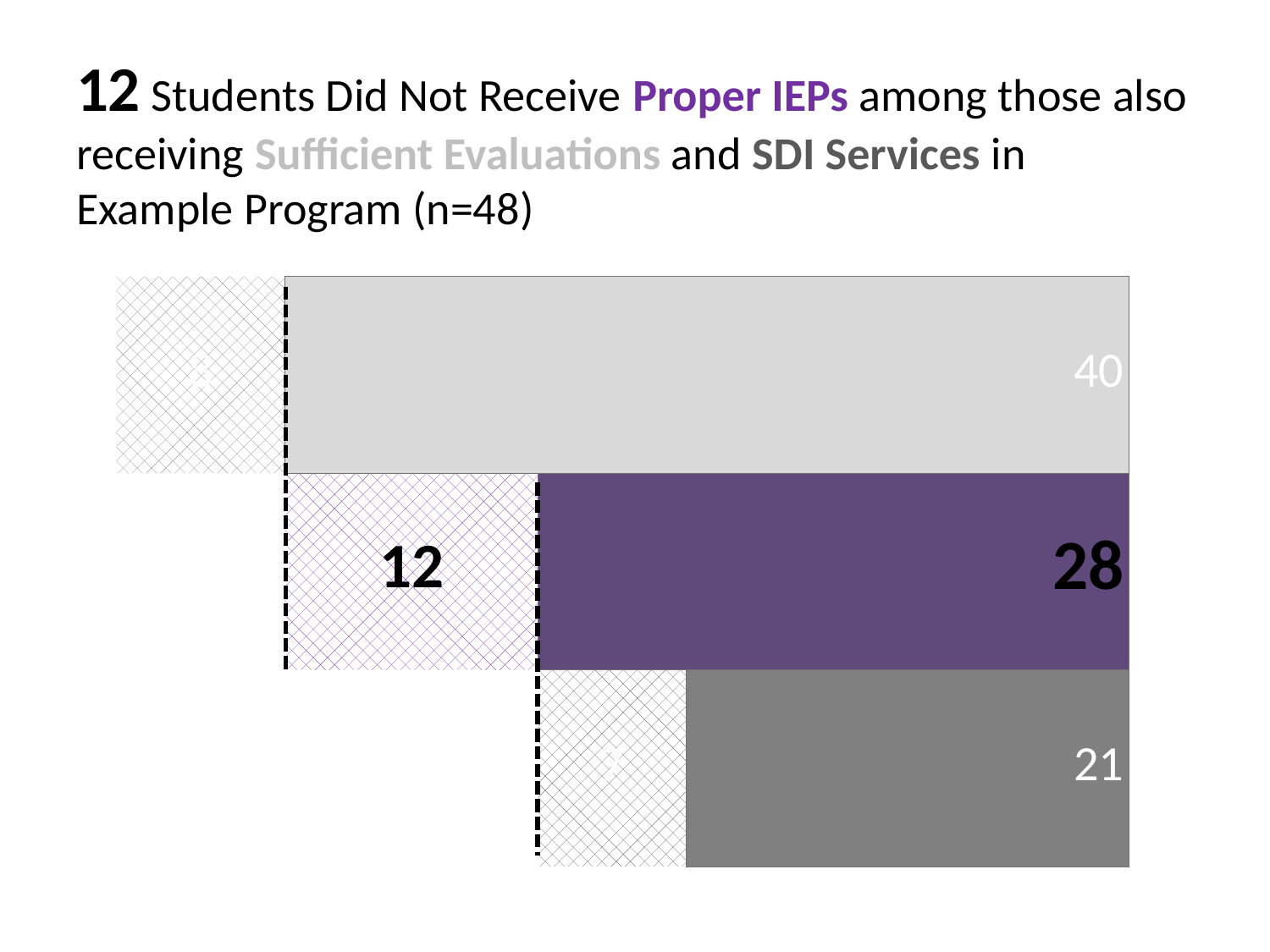
What value is printed on the top (light grey) bar of the chart? 40 Which bar shows the highest printed value: the top light grey bar, the middle purple bar, or the bottom dark grey bar? the top light grey bar What value is printed on the solid purple portion of the middle bar? 28 What is the difference between the value on the top light grey bar (40) and the solid purple value on the middle bar (28)? 12 What is the total of the hatched portion (12) and the solid portion (28) of the middle purple bar? 40 What value is printed on the hatched portion of the middle (purple) bar? 12 What value is printed on the bottom (dark grey) bar of the chart? 21 What type of chart is shown on the slide? bar chart What is the difference between the solid purple value (28) and the bottom dark grey bar value (21)? 7 Which is larger: the value on the top light grey bar or the value on the bottom dark grey bar? the top light grey bar How many bars are shown in the chart? 3